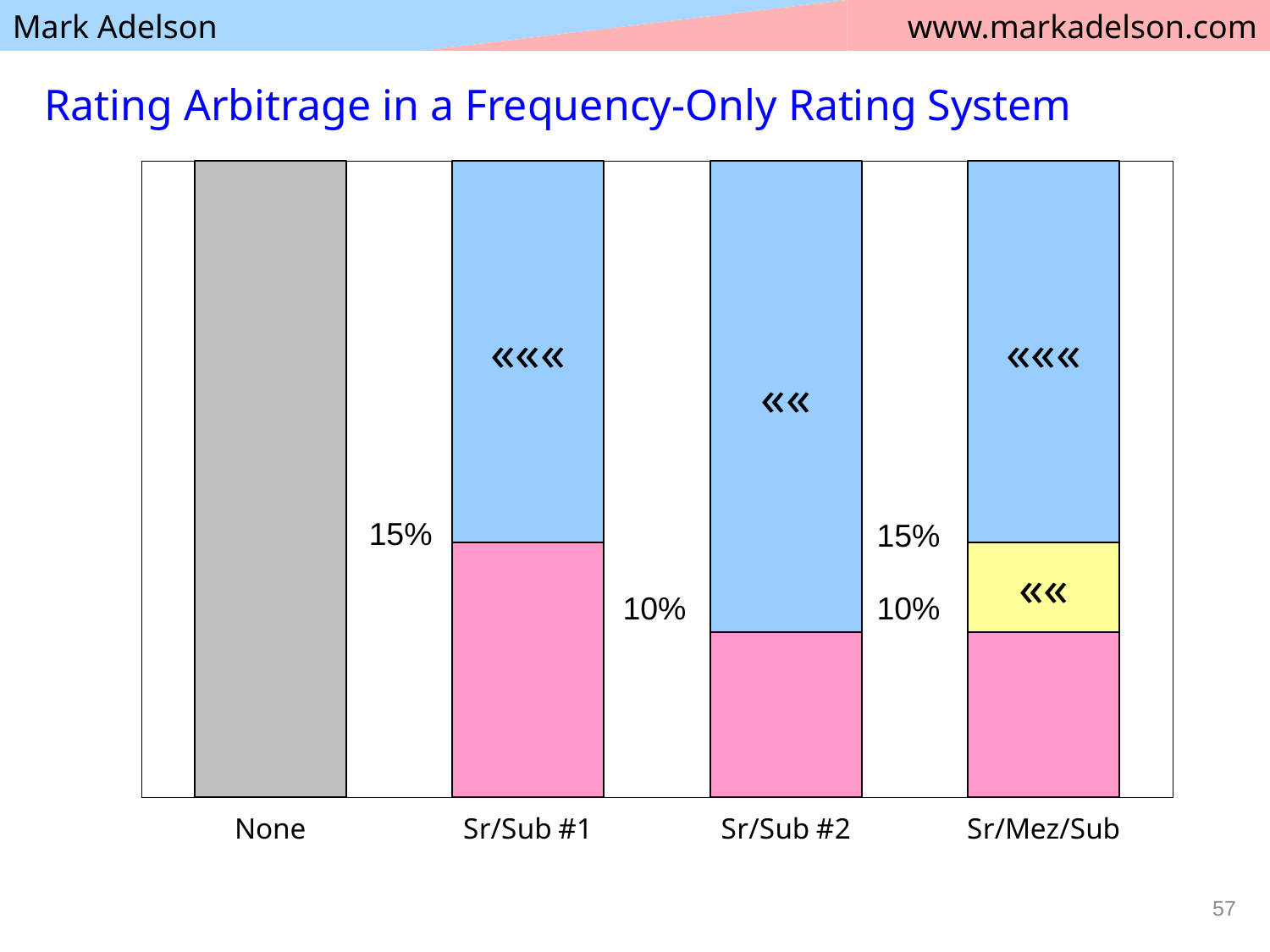
Which bar is divided into three colored segments? Sr/Mez/Sub What is the difference between the marked levels at the top of the pink segments of Sr/Sub #1 and Sr/Sub #2? 5% What is the label of the first bar on the left? None What percentage level is marked at the top of the pink segment of the Sr/Sub #2 bar? 10% What kind of chart is shown on the slide? Stacked bar chart What percentage level is marked at the top of the pink segment of the Sr/Mez/Sub bar? 10% What percentage level is marked at the top of the yellow segment of the Sr/Mez/Sub bar? 15% What percentage level is marked at the top of the pink segment of the Sr/Sub #1 bar? 15% What is the label of the rightmost bar? Sr/Mez/Sub Which bar has a larger pink segment, Sr/Sub #1 or Sr/Sub #2? Sr/Sub #1 Which bar consists of a single gray segment with no subdivisions? None How many bars (categories) are shown in the chart? 4